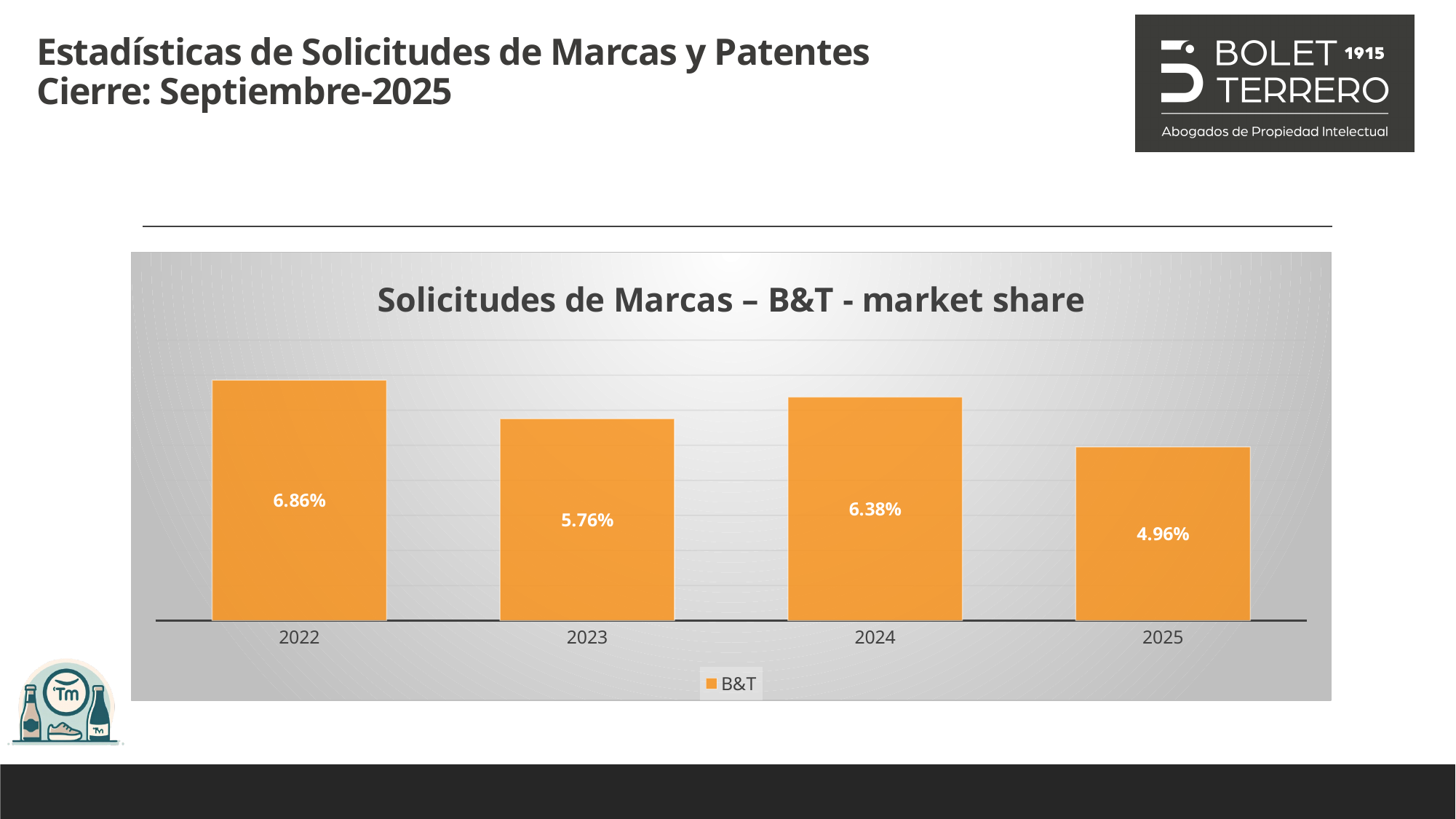
What is the B&T market share for 2025? 4.96% What type of chart is shown on the slide? Bar chart What is the difference in market share between 2022 and 2025? 1.90% What is the B&T market share for 2023? 5.76% What is the title of the chart? Solicitudes de Marcas – B&T - market share What is the B&T market share for 2024? 6.38% How many years are shown on the x axis of the chart? 4 Which year has the lowest B&T market share? 2025 Which year has a larger market share, 2023 or 2024? 2024 What is the difference in market share between 2024 and 2023? 0.62% Which year has the highest B&T market share? 2022 What is the B&T market share for 2022? 6.86%